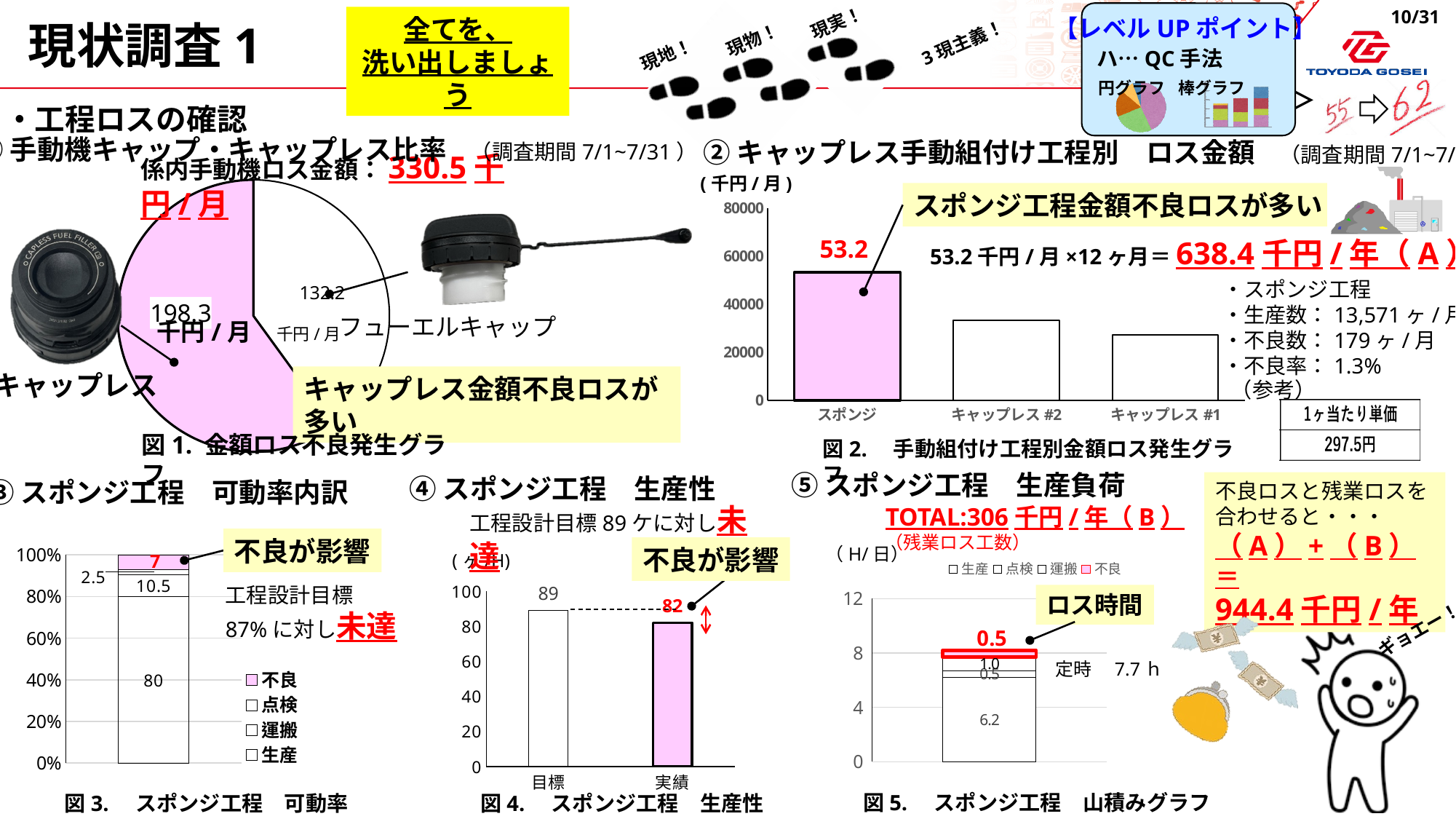
In 図5 (スポンジ工程 山積みグラフ), what is the value of the 生産 segment? 6.2 In 図1 (金額ロス不良発生グラフ), which slice is larger, キャップレス or フューエルキャップ? キャップレス In 図1 (金額ロス不良発生グラフ), what is the value for フューエルキャップ? 132.2 千円/月 In 図2 (手動組付け工程別金額ロス発生グラフ), which category has the highest bar? スポンジ In 図2 (手動組付け工程別金額ロス発生グラフ), which category has the lowest bar? キャップレス #1 What kind of chart is 図1 (金額ロス不良発生グラフ)? pie chart In 図3 (スポンジ工程 可動率), what is the value of the 生産 segment? 80 In 図1 (金額ロス不良発生グラフ), what is the value for キャップレス? 198.3 千円/月 How many series does the legend of 図3 (スポンジ工程 可動率) list? 4 In 図4 (スポンジ工程 生産性), what is the difference between 目標 and 実績? 7 In 図2 (手動組付け工程別金額ロス発生グラフ), is the value for キャップレス #2 greater or less than 40000? less How many categories are shown in 図2 (手動組付け工程別金額ロス発生グラフ)? 3